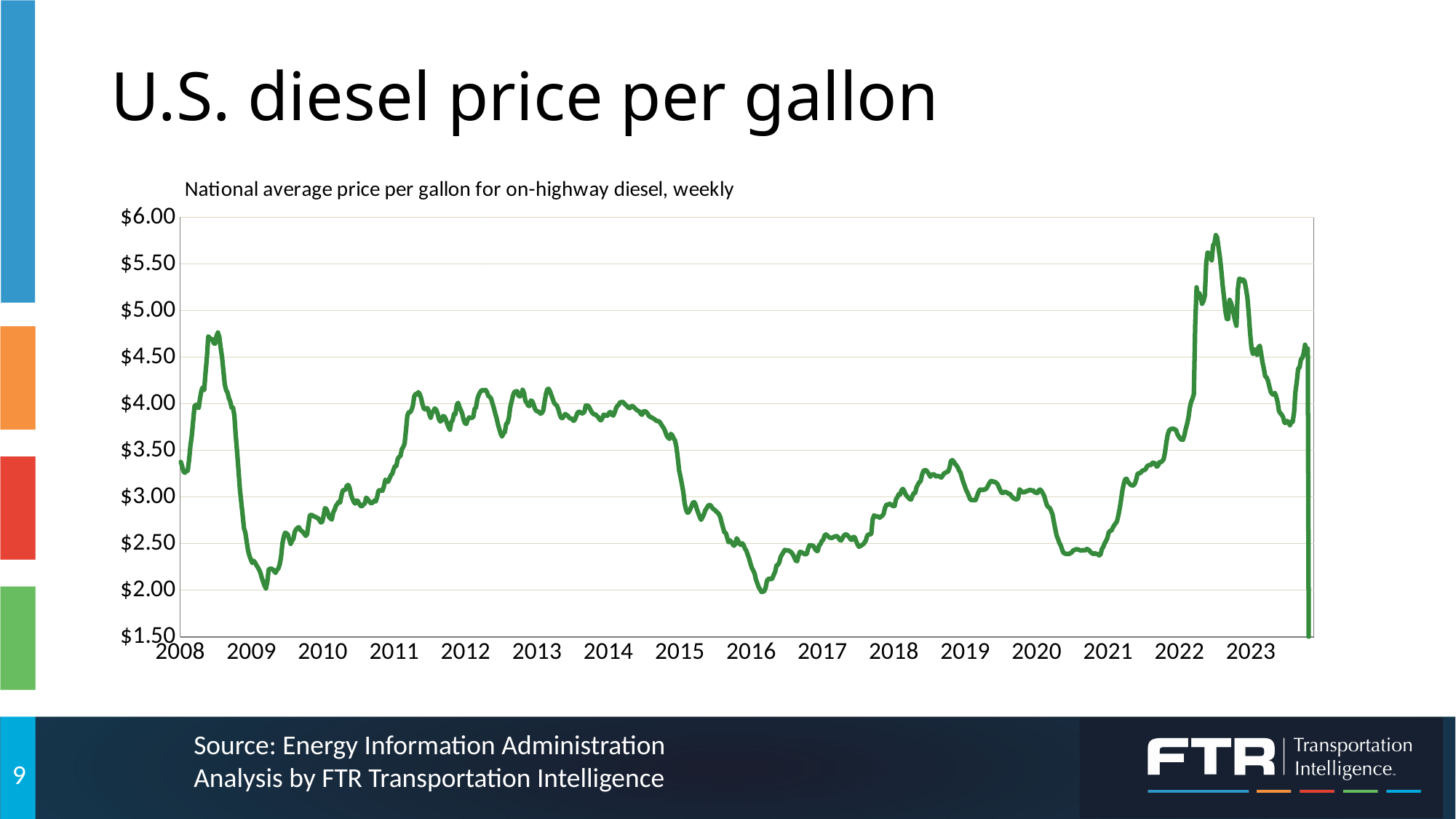
Is the diesel price at the start of 2008 greater or less than $3.00? greater Does the diesel price rise or fall from early 2021 to mid-2022? rise Is the lowest diesel price in 2016 greater or less than $2.50? less What is the title of the slide's chart? National average price per gallon for on-highway diesel, weekly Is the lowest diesel price in 2020 greater or less than $3.00? less Which is higher, the peak diesel price in 2008 or the peak diesel price in 2022? 2022 What kind of chart is shown on the slide? line chart What does the chart's subtitle say the data represents? National average price per gallon for on-highway diesel, weekly In which year does the diesel price reach its highest peak on the chart? 2022 Does the diesel price rise or fall from the end of 2014 to early 2016? fall